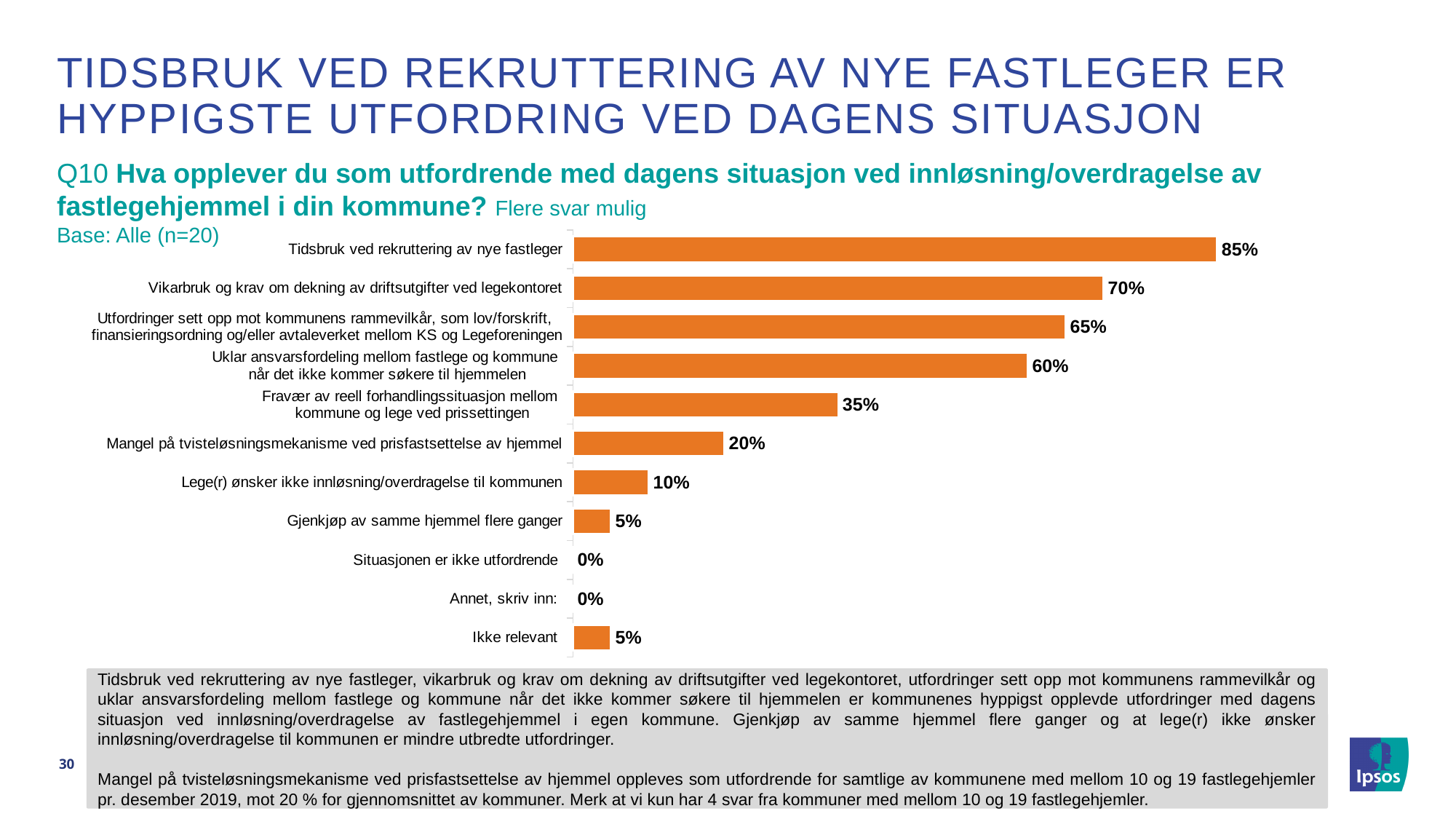
How many categories have a value of 0%? 2 What is the value for "Vikarbruk og krav om dekning av driftsutgifter ved legekontoret"? 70% How many categories are shown in the chart? 11 What is the value for "Tidsbruk ved rekruttering av nye fastleger"? 85% Which category has the highest value? Tidsbruk ved rekruttering av nye fastleger What is the value for "Ikke relevant"? 5% What is the value for "Mangel på tvisteløsningsmekanisme ved prisfastsettelse av hjemmel"? 20% Which is larger: the value for "Lege(r) ønsker ikke innløsning/overdragelse til kommunen" or the value for "Gjenkjøp av samme hjemmel flere ganger"? Lege(r) ønsker ikke innløsning/overdragelse til kommunen What is the difference between the values for "Uklar ansvarsfordeling mellom fastlege og kommune når det ikke kommer søkere til hjemmelen" and "Fravær av reell forhandlingssituasjon mellom kommune og lege ved prissettingen"? 25% What is the base (n) stated for the chart? Alle (n=20) What kind of chart is shown on the slide? Bar chart What is the difference between the values for "Tidsbruk ved rekruttering av nye fastleger" and "Vikarbruk og krav om dekning av driftsutgifter ved legekontoret"? 15%